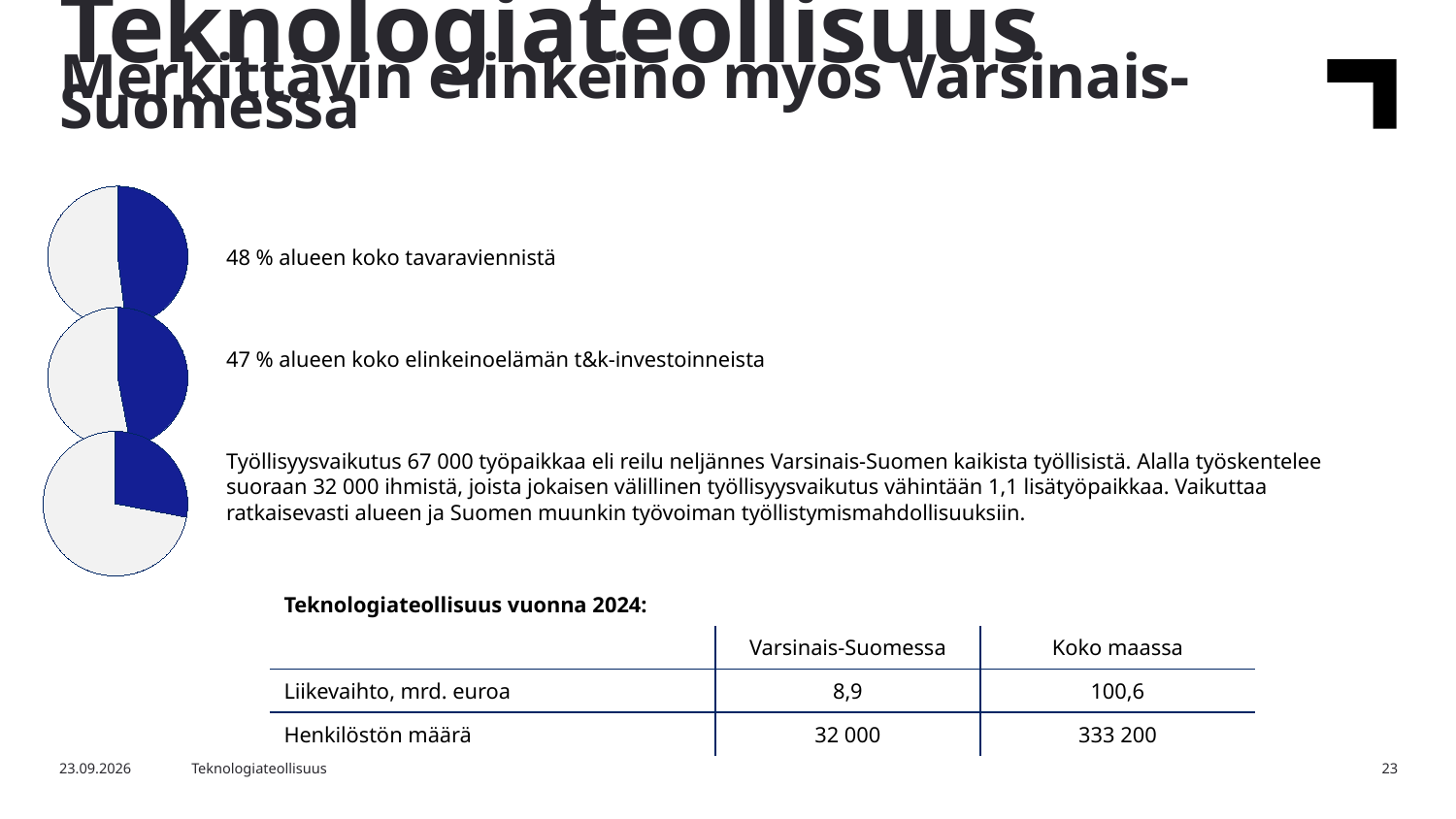
Is the blue slice larger in the top pie chart or in the bottom pie chart? Top In the top pie chart, what share of the region's total goods exports (tavaravienti) does the blue slice represent? 48 % Which pie chart has the smallest blue slice: the top, middle or bottom one? Bottom Is the blue slice in the bottom pie chart more or less than half of the pie? Less What kind of charts are shown on the left side of the slide? Pie charts How many pie charts are on the slide? 3 How many slices does each pie chart have? 2 What colour is the highlighted slice in the pie charts? Blue In the middle pie chart, what share of the region's business R&D investments (t&k-investoinnit) does the blue slice represent? 47 % Do the pie charts have a legend? No